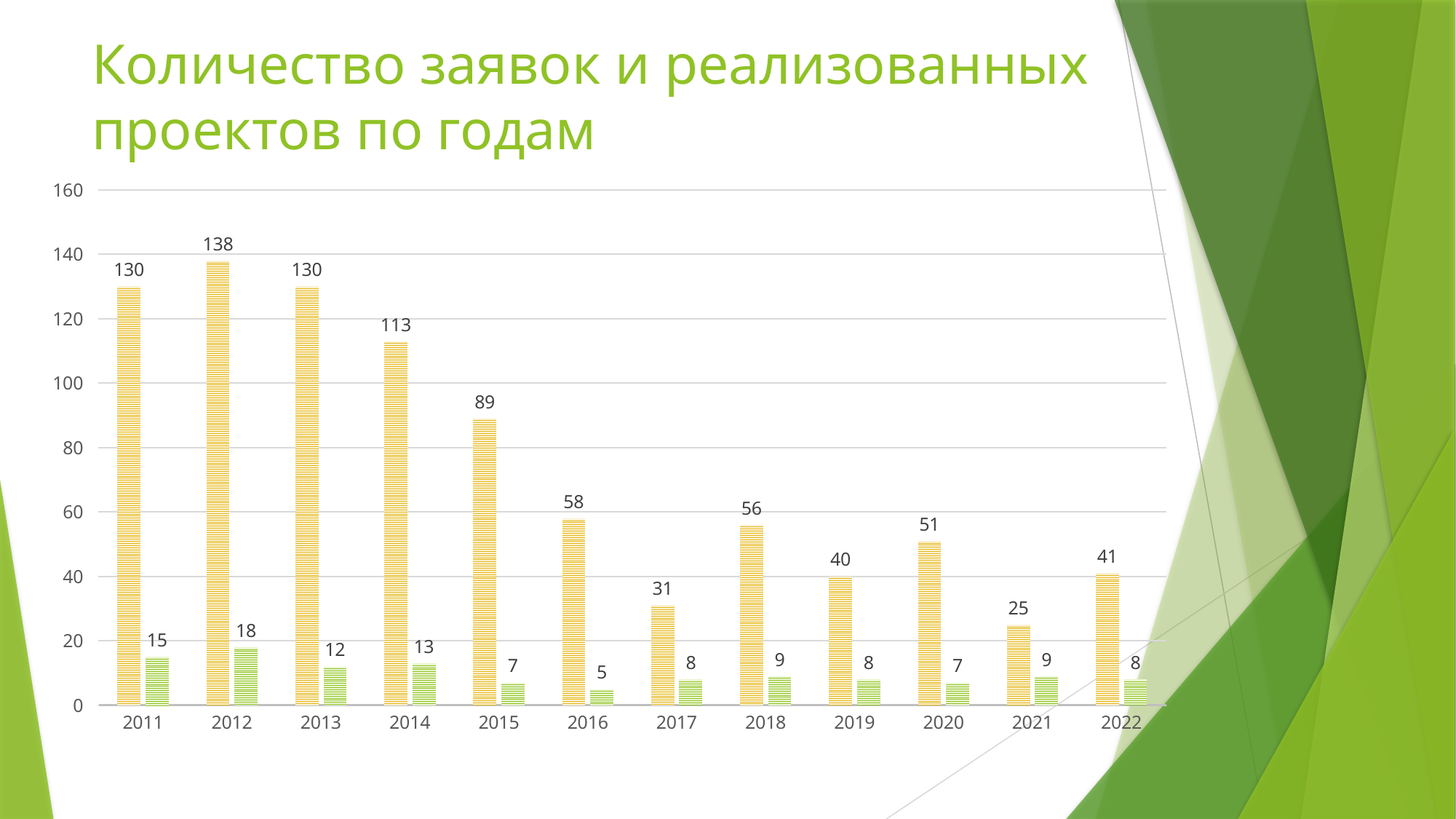
Which year has the lowest green bar? 2016 Is the orange bar for 2015 greater or less than 100? less What kind of chart is shown on the slide? bar chart What is the value of the orange bar for 2012? 138 Which year has the highest orange bar? 2012 Which year has the lowest orange bar? 2021 Which is larger, the orange bar for 2018 or the orange bar for 2020? 2018 What is the difference between the orange bar values for 2011 and 2014? 17 What is the value of the green bar for 2014? 13 What is the value of the orange bar for 2019? 40 What is the title of the chart? Количество заявок и реализованных проектов по годам How many years are shown on the x axis? 12